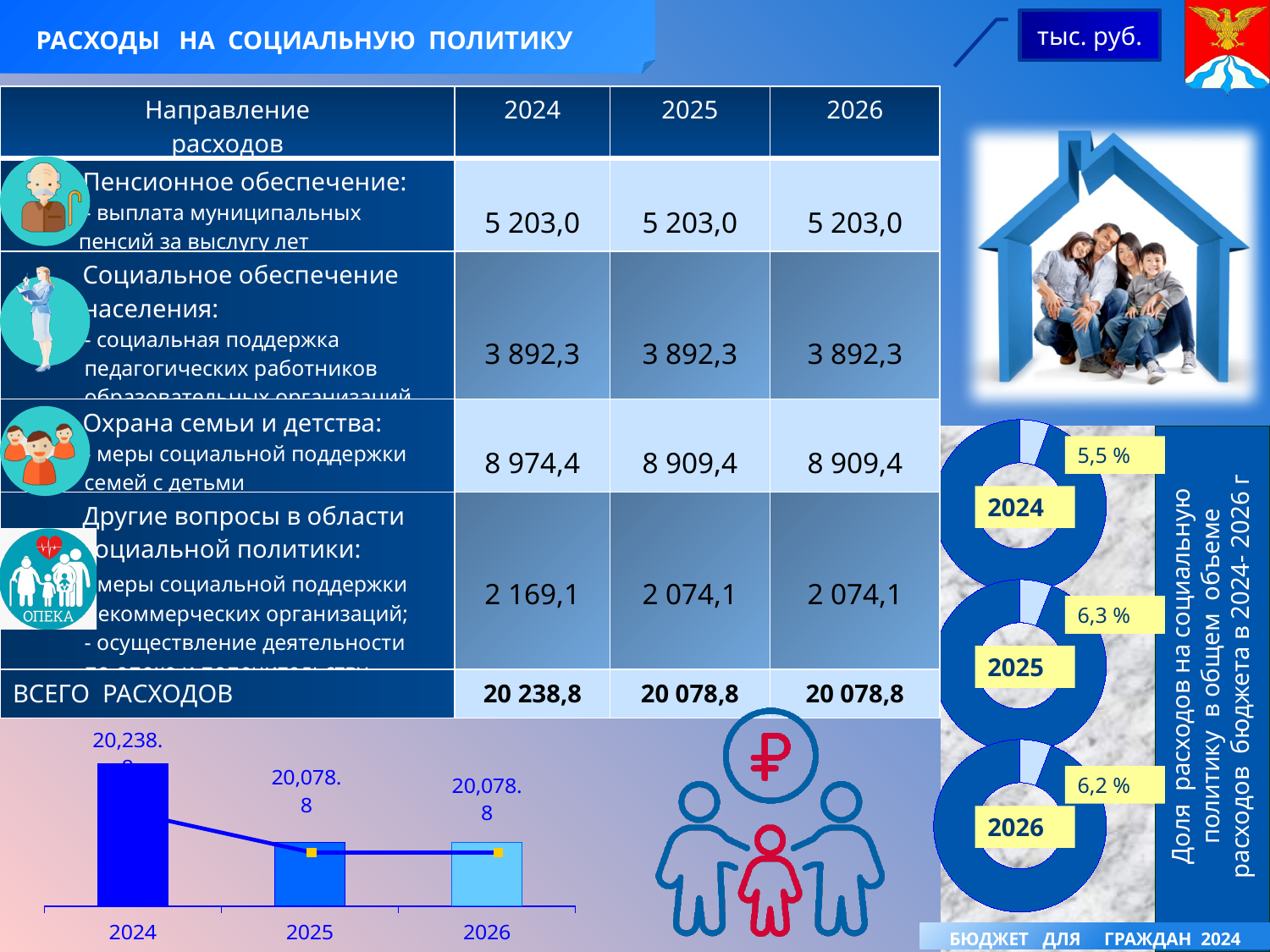
In the bar chart at the bottom left, how many years are shown on the x axis? 3 In the donut charts on the right, which year has the highest share? 2025 In the donut charts on the right, what share is shown for 2025? 6,3 % In the bar chart at the bottom left, what is the value for 2026? 20,078.8 In the donut charts on the right, what share is shown for 2024? 5,5 % In the bar chart at the bottom left, do the values rise or fall from 2024 to 2025? fall In the bar chart at the bottom left, which year has the highest bar? 2024 In the bar chart at the bottom left, is the bar for 2024 taller or shorter than the bar for 2025? taller What kind of chart is shown at the bottom left of the slide? bar chart In the bar chart at the bottom left, what is the value for 2025? 20,078.8 In the donut charts on the right, which year has the lowest share? 2024 In the donut charts on the right, what share is shown for 2026? 6,2 %